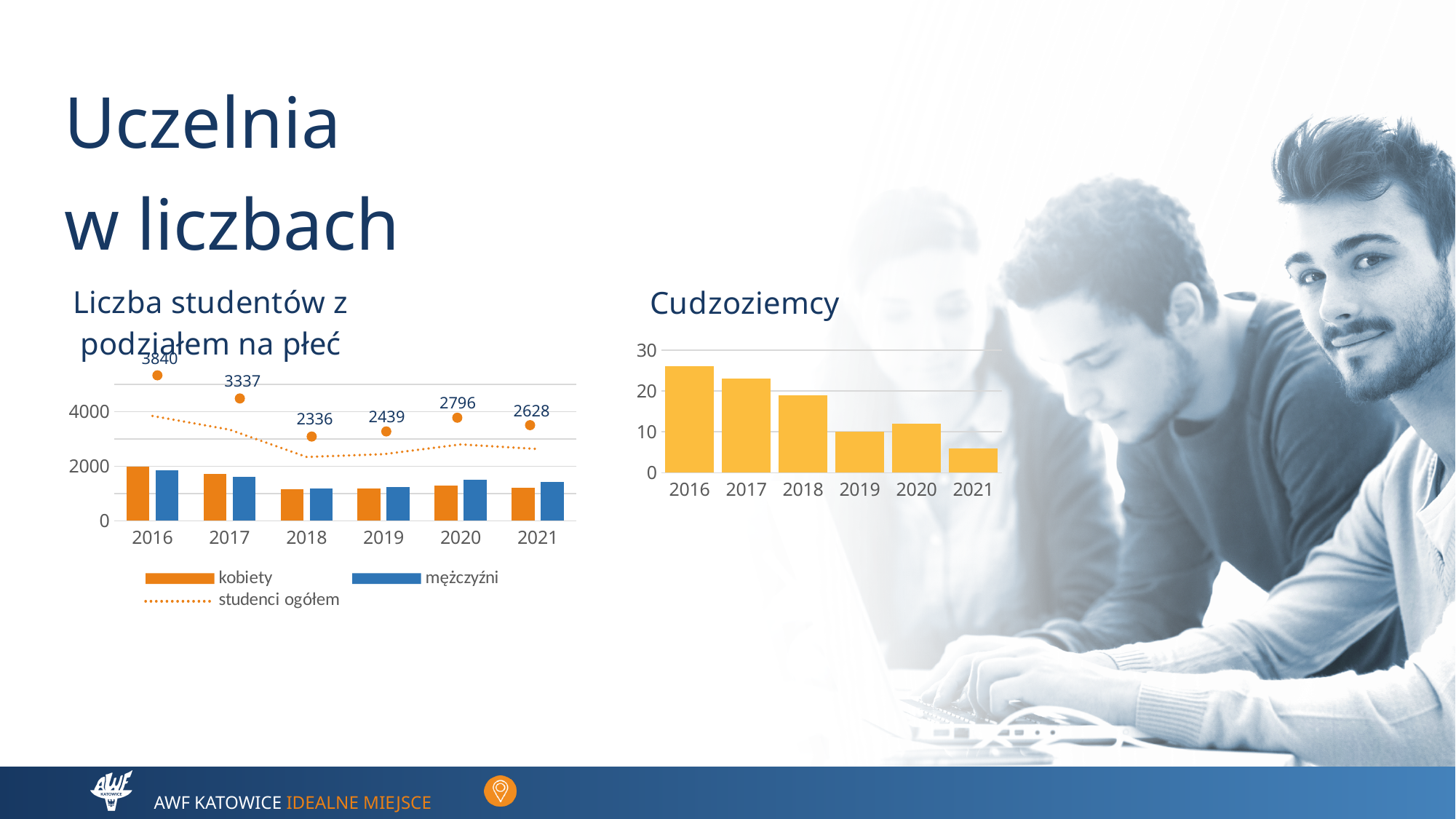
In the chart 'Liczba studentów z podziałem na płeć', what is the value of 'studenci ogółem' for 2020? 2796 How many series does the legend of the chart 'Liczba studentów z podziałem na płeć' list? 3 In the chart 'Liczba studentów z podziałem na płeć', which year has the highest value of 'studenci ogółem'? 2016 In the chart 'Liczba studentów z podziałem na płeć', which bar is taller in 2021, 'kobiety' or 'mężczyźni'? mężczyźni In the chart 'Liczba studentów z podziałem na płeć', what is the value of 'studenci ogółem' for 2016? 3840 In the chart 'Liczba studentów z podziałem na płeć', which year has the lowest value of 'studenci ogółem'? 2018 In the chart 'Cudzoziemcy', which year has the highest value? 2016 In the chart 'Cudzoziemcy', is the value for 2017 greater or less than 20? greater In the chart 'Cudzoziemcy', which year has the lowest value? 2021 In the chart 'Liczba studentów z podziałem na płeć', is the value for 'kobiety' in 2018 greater or less than 2000? less How many years are shown on the x axis of the chart 'Cudzoziemcy'? 6 In the chart 'Liczba studentów z podziałem na płeć', what is the difference between 'studenci ogółem' in 2016 and 2017? 503